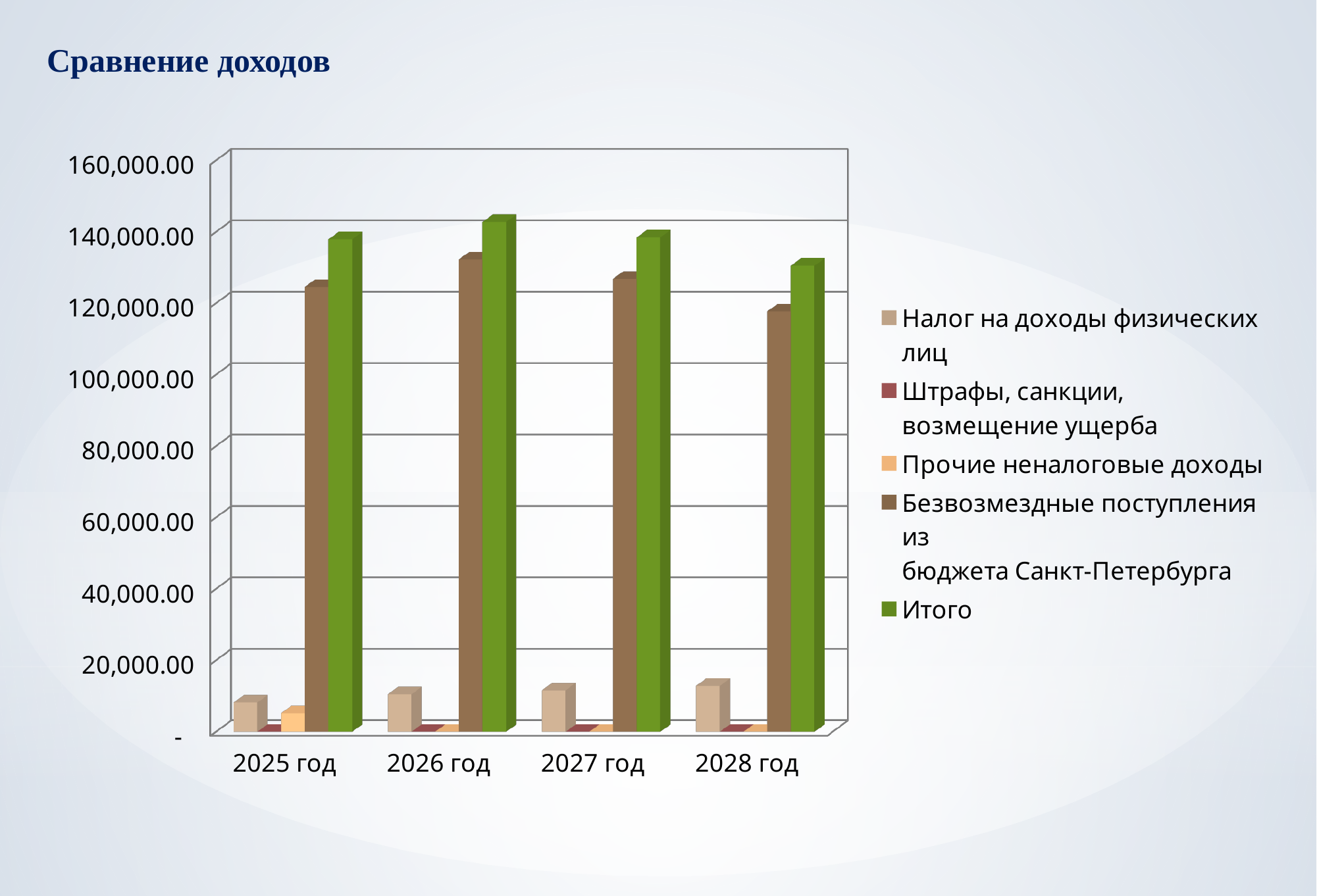
Which series is shown in green? Итого Is the value for Безвозмездные поступления из бюджета Санкт-Петербурга in 2028 год greater or less than 120,000.00? less How many series does the legend list? 5 Is the value for Итого in 2028 год greater or less than 120,000.00? greater In which year is the value for Итого the lowest? 2028 год In which year is the value for Безвозмездные поступления из бюджета Санкт-Петербурга the lowest? 2028 год How many year categories are shown on the x axis? 4 In which year is the value for Итого the highest? 2026 год What kind of chart is shown on the slide? bar chart What is the title of the chart? Сравнение доходов Does the value for Налог на доходы физических лиц rise or fall from 2025 год to 2028 год? rise Which is larger: the value for Итого in 2026 год or in 2028 год? 2026 год